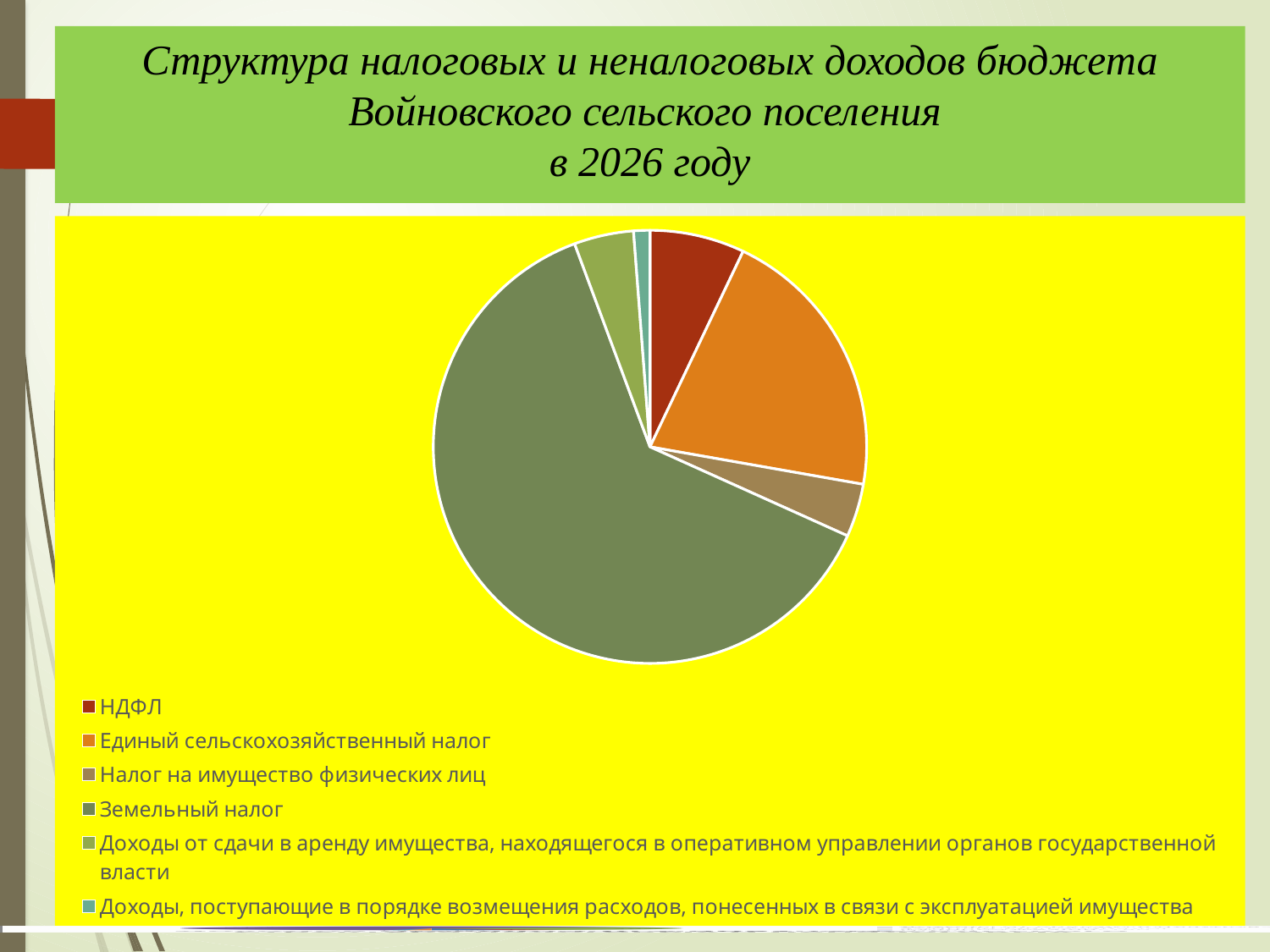
Does the slice for Земельный налог take up more or less than half of the pie? more How many slices does the pie chart have? 6 What kind of chart is shown on the slide? pie chart Which category has the largest slice of the pie chart? Земельный налог How many entries does the legend of the pie chart list? 6 Which category has the smallest slice of the pie chart? Доходы, поступающие в порядке возмещения расходов, понесенных в связи с эксплуатацией имущества Which slice is larger: Земельный налог or Единый сельскохозяйственный налог? Земельный налог What is the title of the slide containing the pie chart? Структура налоговых и неналоговых доходов бюджета Войновского сельского поселения в 2026 году What colour is the slice for Единый сельскохозяйственный налог? orange Which slice is larger: НДФЛ or Налог на имущество физических лиц? НДФЛ Which slice is larger: Единый сельскохозяйственный налог or НДФЛ? Единый сельскохозяйственный налог